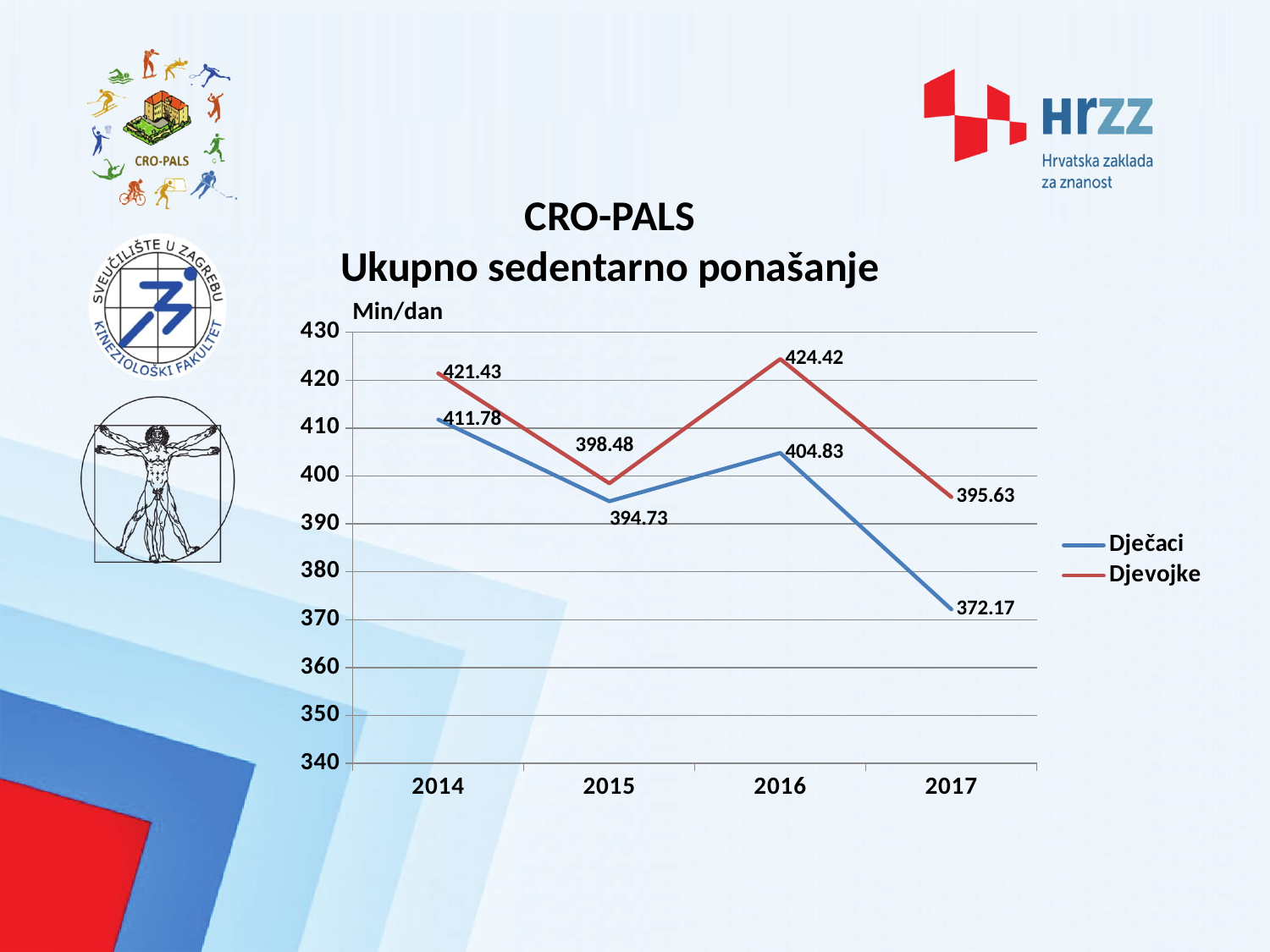
What is the value for Dječaci in 2017? 372.17 What kind of chart is shown on the slide? Line chart What is the value for Djevojke in 2016? 424.42 In which year is the Djevojke value highest? 2016 What is the value for Dječaci in 2014? 411.78 What is the value for Djevojke in 2015? 398.48 What is the difference between the Djevojke and Dječaci values in 2017? 23.46 In which year is the Dječaci value lowest? 2017 Which series has the larger value in 2015, Dječaci or Djevojke? Djevojke How many series does the legend list? 2 What unit is shown on the y axis of the chart? Min/dan How many years are shown on the x axis? 4